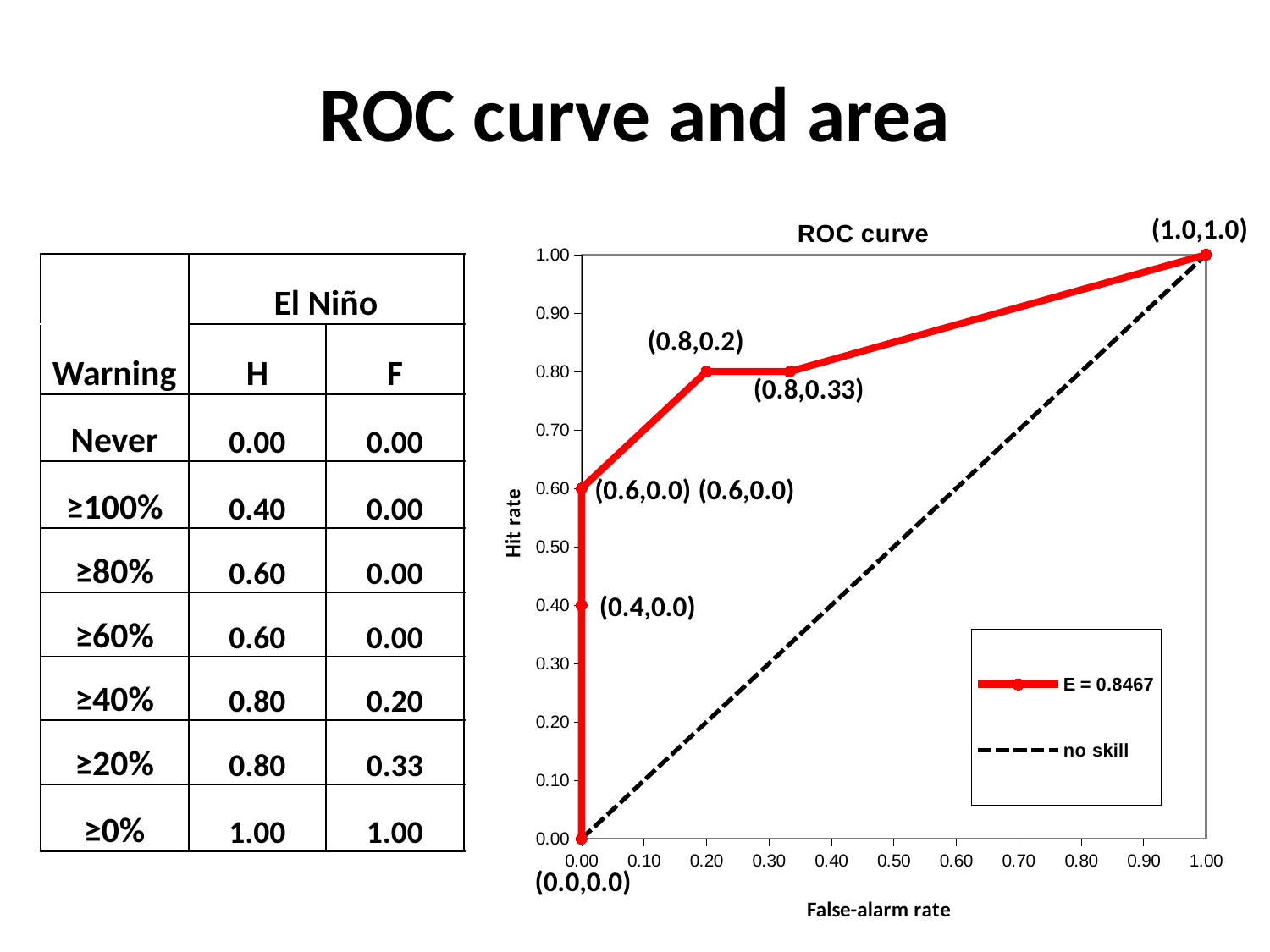
What kind of chart is the ROC curve chart? line chart In the ROC curve chart, at a false-alarm rate of 0.20, which line has the higher hit rate: the red E = 0.8467 curve or the no skill line? E = 0.8467 In the ROC curve chart, what is the hit rate of the red curve at a false-alarm rate of 0.2? 0.8 What is the x-axis title of the ROC curve chart? False-alarm rate In the ROC curve chart, is the hit rate of the red curve at a false-alarm rate of 0.20 greater or less than 0.50? greater In the ROC curve chart, how many coordinate labels are printed along the red curve? 7 How many series does the legend of the ROC curve chart list? 2 In the ROC curve chart, does the hit rate of the red curve rise or fall as the false-alarm rate increases? rises In the ROC curve chart, what is the difference between the hit rate at the point labelled (0.8,0.2) and the hit rate at the point labelled (0.4,0.0)? 0.4 What is the legend entry for the solid red line in the ROC curve chart? E = 0.8467 In the ROC curve chart, what are the coordinates printed at the top-right end of the red curve? (1.0,1.0) In the ROC curve chart, what is the hit rate of the red curve at a false-alarm rate of 0.33? 0.8